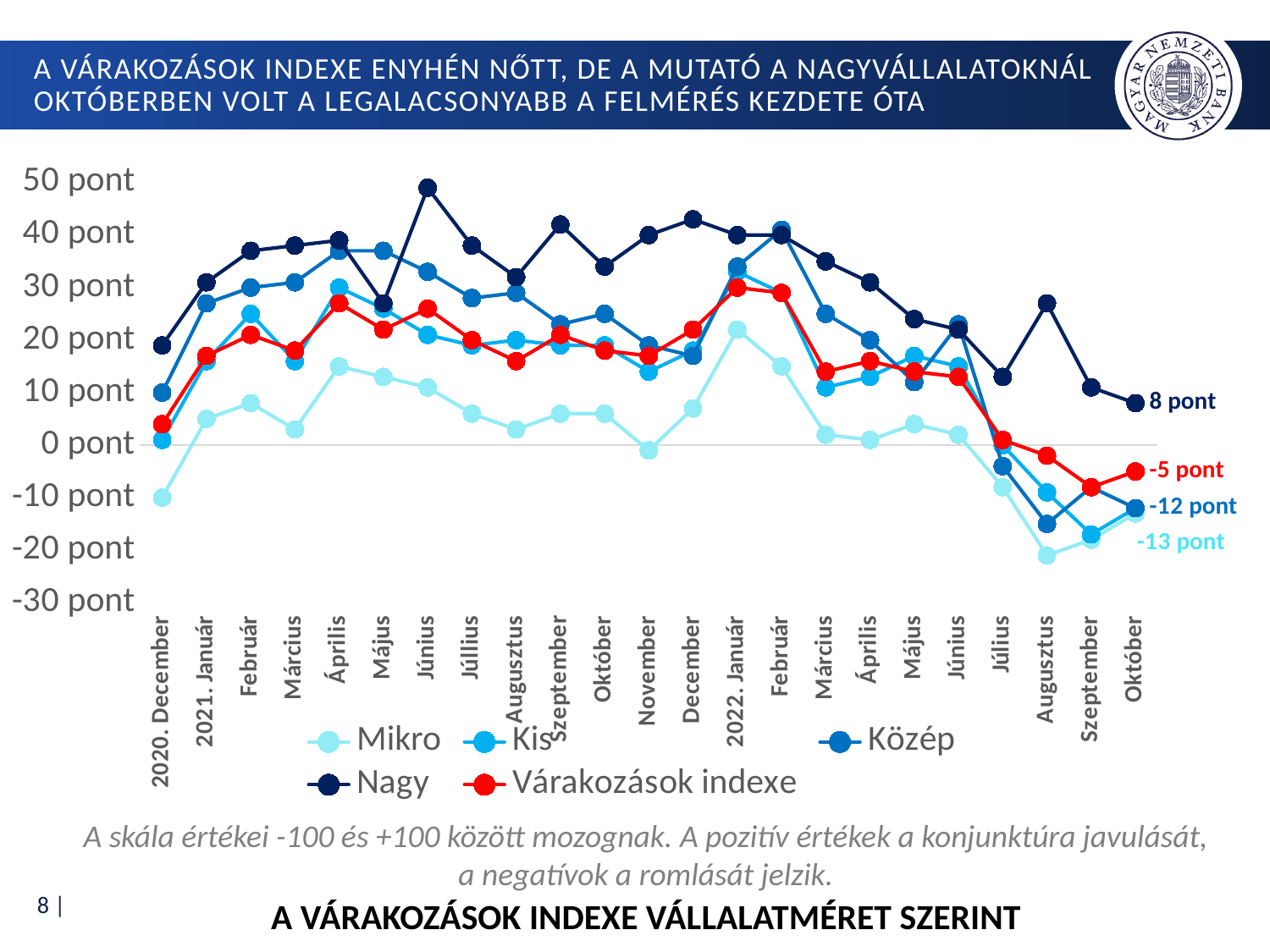
What is the difference between the Nagy value and the Várakozások indexe value in 2022 Október? 13 pont Is the value of the Nagy series in 2021 Június greater or less than 40 pont? greater Which series has the highest value in 2022 Október? Nagy How many months (points) are shown along the x axis? 23 Does the Nagy series rise or fall between 2022 Február and 2022 Július? fall In which month does the Nagy series reach its highest value? 2021 Június What is the value of the Nagy series in 2022 Október? 8 pont What is the value of the Mikro series in 2022 Október? -13 pont What is the value of the Várakozások indexe series in 2022 Október? -5 pont How many series does the legend list? 5 What type of chart is shown on the slide? line chart What is the title of the chart shown at the bottom of the slide? A VÁRAKOZÁSOK INDEXE VÁLLALATMÉRET SZERINT